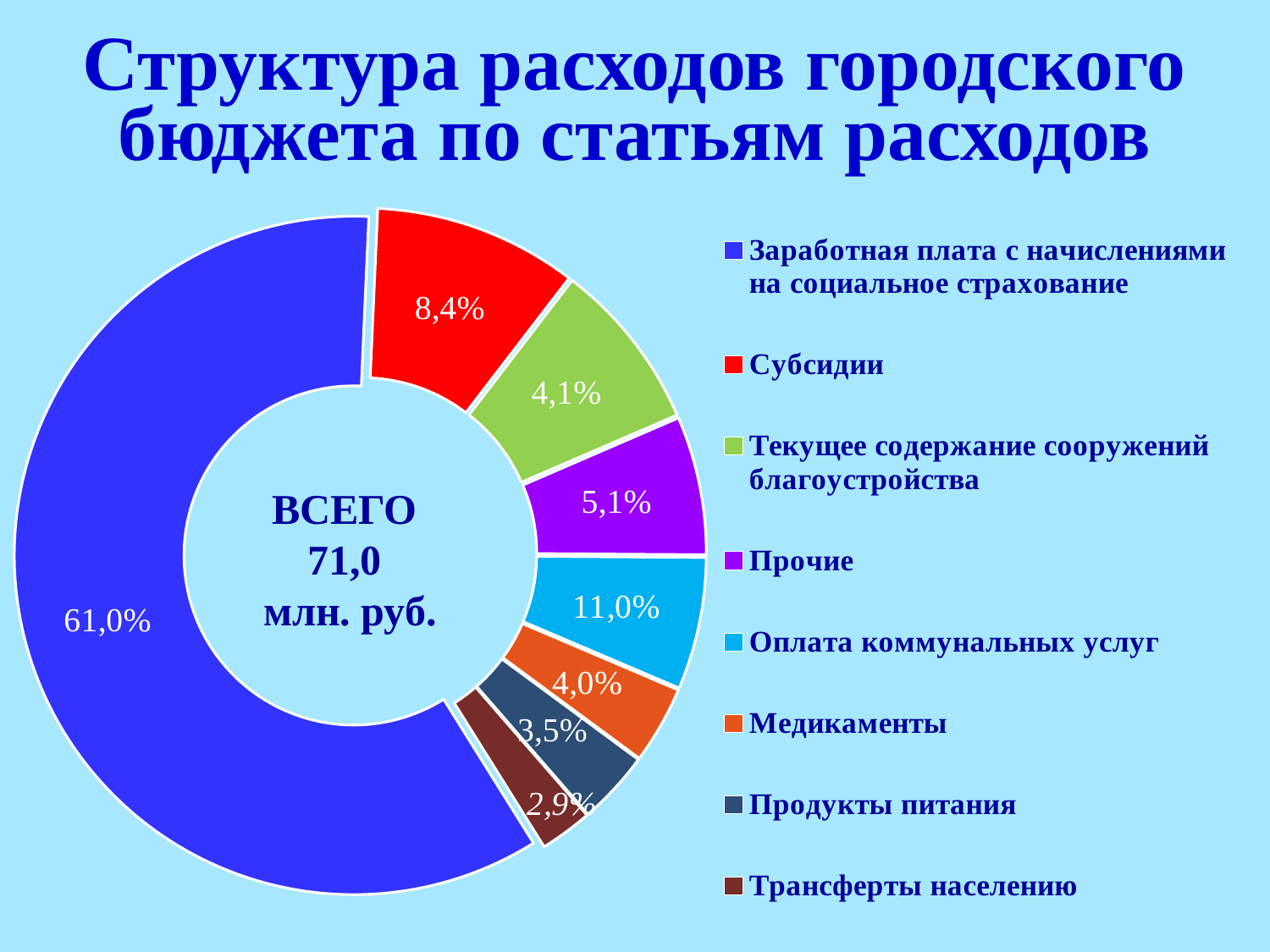
What type of chart is shown on the slide? Doughnut chart What is the value shown for Субсидии? 8,4% What percentage of expenditure is shown for Оплата коммунальных услуг? 11,0% What is the difference in percentage points between Оплата коммунальных услуг and Субсидии? 2,6 What total amount is shown in the centre of the chart? ВСЕГО 71,0 млн. руб. Which colour represents Продукты питания in the legend? Dark blue What share of the city budget expenditure goes to Заработная плата с начислениями на социальное страхование? 61,0% Which is larger: the share for Прочие or the share for Медикаменты? Прочие What percentage is shown for Трансферты населению? 2,9% How many expenditure items are shown in the chart? 8 Which expenditure item has the largest share of the budget? Заработная плата с начислениями на социальное страхование Which expenditure item has the smallest share of the budget? Трансферты населению